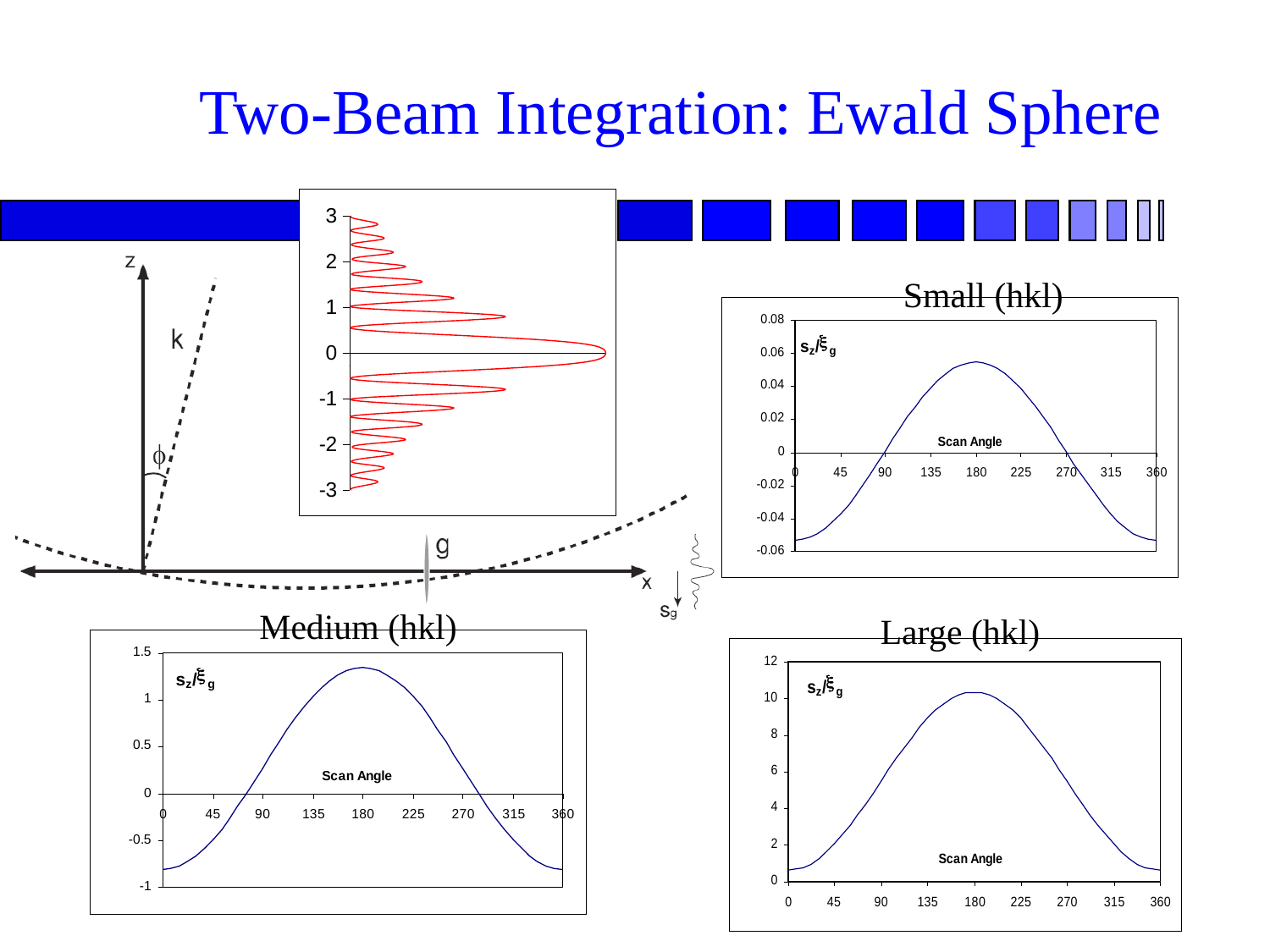
In the Large (hkl) chart, is the value at a scan angle of 0 greater or less than 2? less How many tick labels are shown on the x axis of the Small (hkl) chart? 9 In the Small (hkl) chart, is the value at a scan angle of 180 greater or less than 0.04? greater What is the highest value shown on the y axis of the Large (hkl) chart? 12 In the Medium (hkl) chart, is the value at a scan angle of 180 greater or less than 1? greater What is the x-axis label on the Medium (hkl) chart? Scan Angle In the Medium (hkl) chart, does the curve rise or fall as the scan angle goes from 180 to 360? falls What kind of chart is the Large (hkl) chart? line chart In the Large (hkl) chart, does the curve rise or fall as the scan angle goes from 0 to 180? rises In the Small (hkl) chart, at which scan angle does the curve reach its highest value? 180